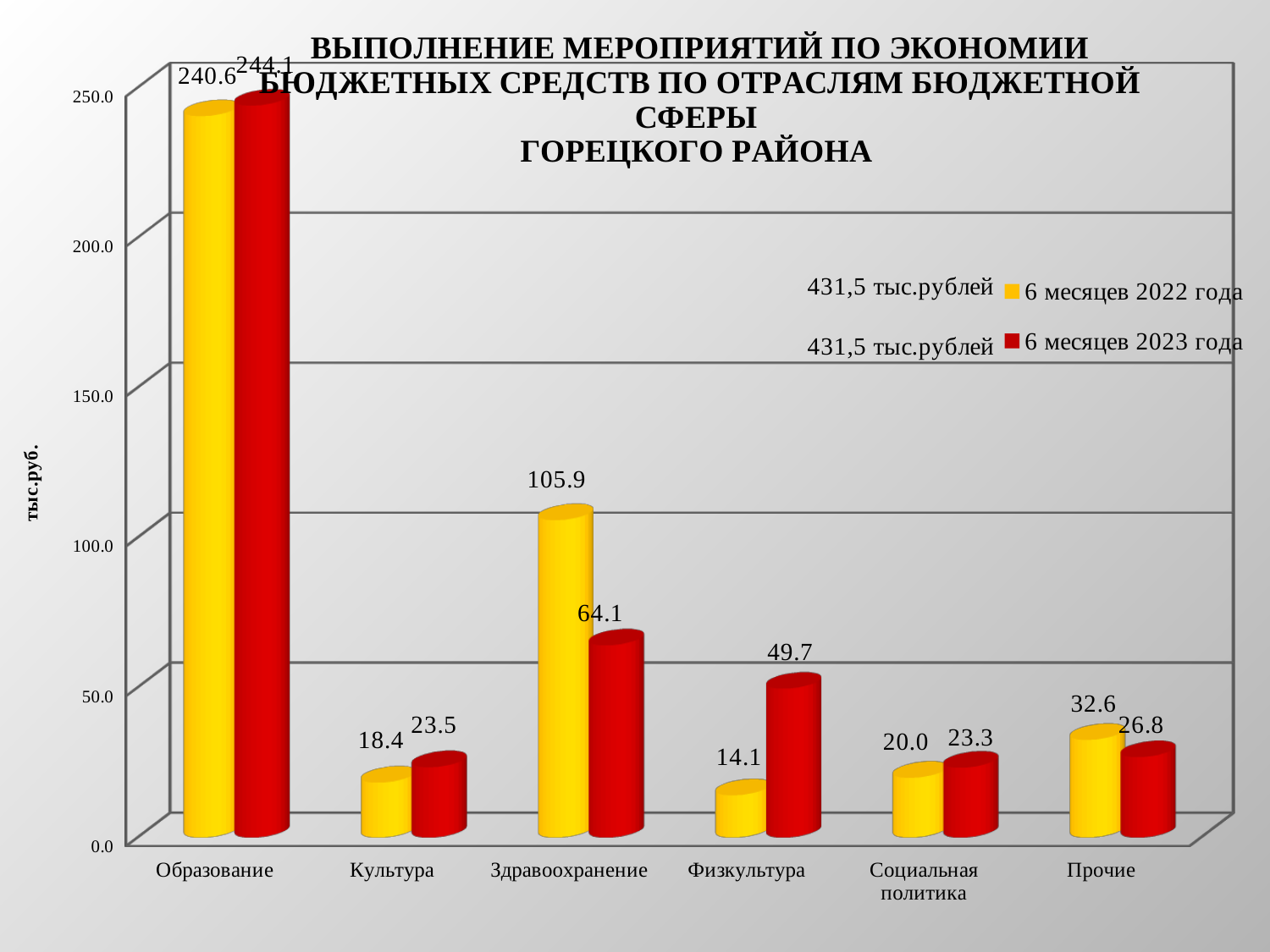
What is the difference between the 6 месяцев 2022 года and 6 месяцев 2023 года values for Здравоохранение? 41.8 What is the value for Физкультура in the series 6 месяцев 2023 года? 49.7 Which is larger for Прочие: the 6 месяцев 2022 года value or the 6 месяцев 2023 года value? 6 месяцев 2022 года How many series does the legend list? 2 Which category has the highest value in the series 6 месяцев 2023 года? Образование What is the difference between the 6 месяцев 2023 года and 6 месяцев 2022 года values for Физкультура? 35.6 What is the value for Прочие in the series 6 месяцев 2022 года? 32.6 What is the value for Здравоохранение in the series 6 месяцев 2022 года? 105.9 What kind of chart is shown on the slide? Bar chart Which category has the lowest value in the series 6 месяцев 2022 года? Физкультура How many categories are shown on the x axis? 6 Which is larger for Культура: the 6 месяцев 2022 года value or the 6 месяцев 2023 года value? 6 месяцев 2023 года